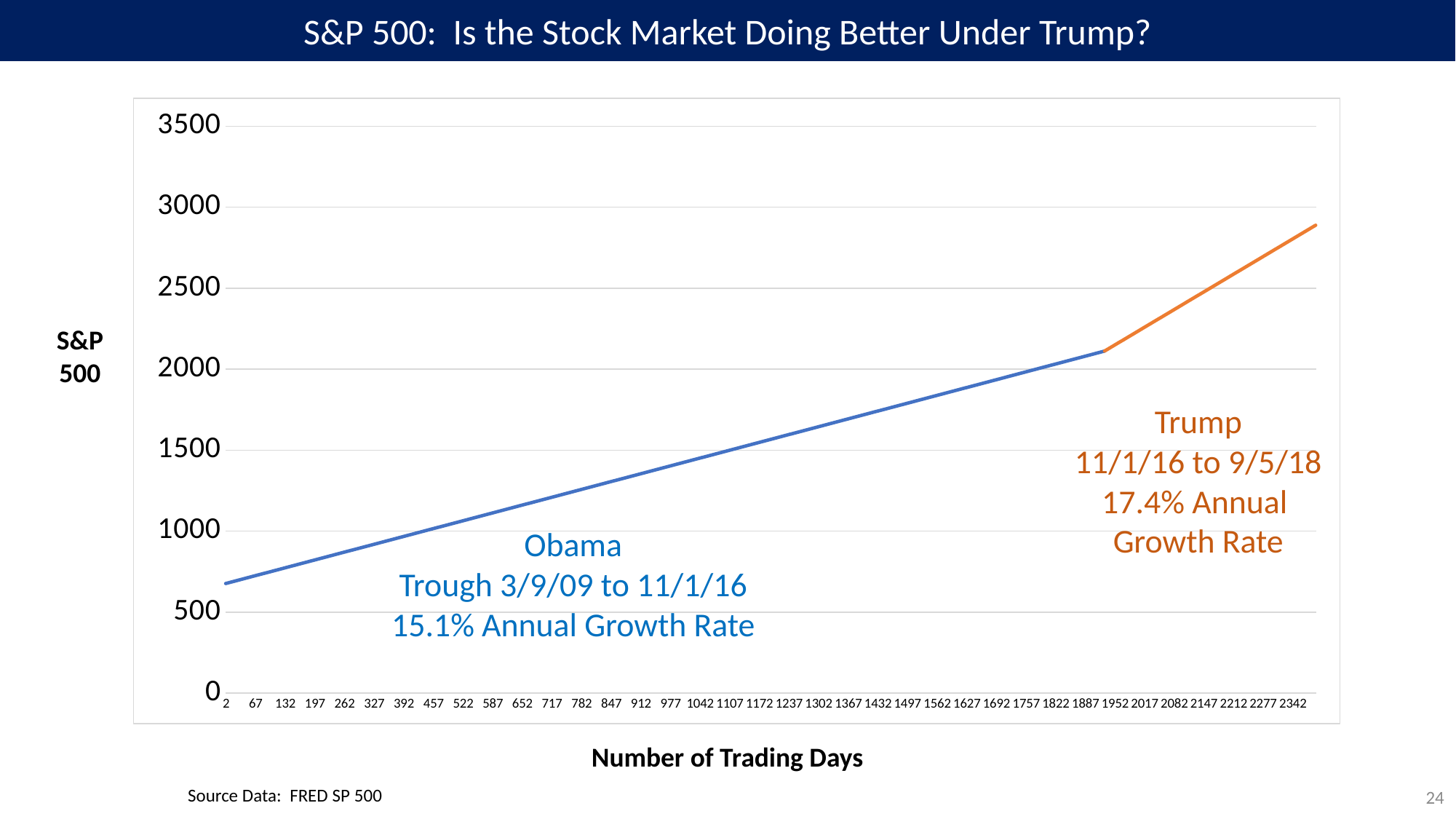
Does the S&P 500 rise or fall as the number of trading days increases? Rise What annual growth rate is shown for the Trump period (11/1/16 to 9/5/18)? 17.4% What type of chart is shown on the slide? Line chart Is the S&P 500 value at the end of the Trump segment (trading day 2342) greater or less than 2500? greater How many presidential periods are plotted as separate line segments on the chart? 2 What is the title of the x axis? Number of Trading Days By how many percentage points does the Trump annual growth rate exceed the Obama annual growth rate? 2.3 percentage points What is the highest value shown on the y axis? 3500 What annual growth rate is shown for the Obama period (Trough 3/9/09 to 11/1/16)? 15.1% Which period has the higher annual growth rate, Obama or Trump? Trump Is the S&P 500 value at trading day 2 greater or less than 1000? less Is the S&P 500 value at trading day 1302 greater or less than 2000? less